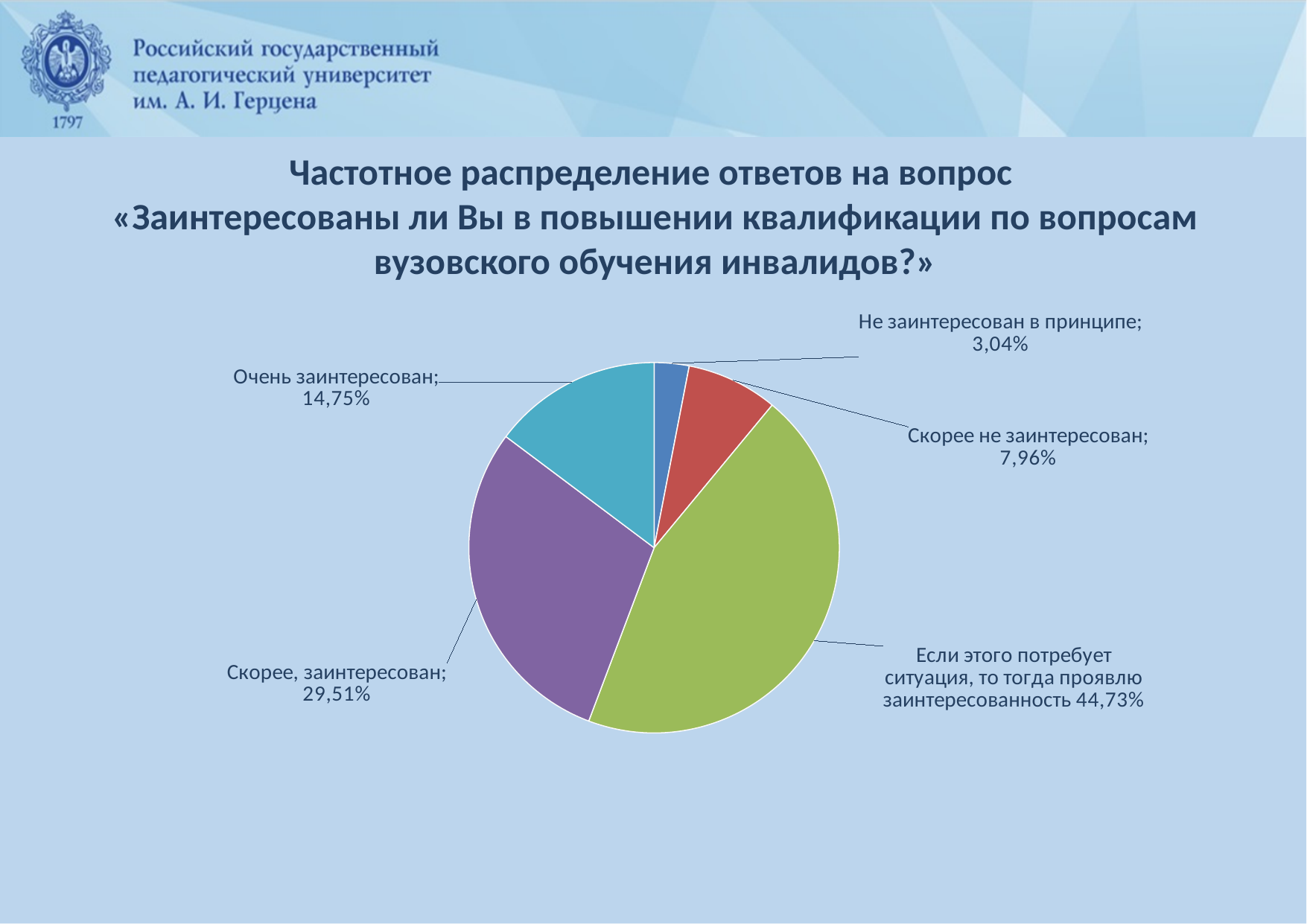
What share of respondents answered «Если этого потребует ситуация, то тогда проявлю заинтересованность»? 44,73% Which is larger: the share for «Очень заинтересован» or the share for «Скорее не заинтересован»? Очень заинтересован What share of respondents answered «Не заинтересован в принципе»? 3,04% How many slices does the pie chart have? 5 Which answer option has the largest share of the pie? Если этого потребует ситуация, то тогда проявлю заинтересованность What share of respondents answered «Скорее, заинтересован»? 29,51% What kind of chart is shown on the slide? Pie chart By how many percentage points does «Если этого потребует ситуация, то тогда проявлю заинтересованность» exceed «Скорее, заинтересован»? 15,22 What colour is the slice for «Скорее, заинтересован»? Purple Which answer option has the smallest share of the pie? Не заинтересован в принципе